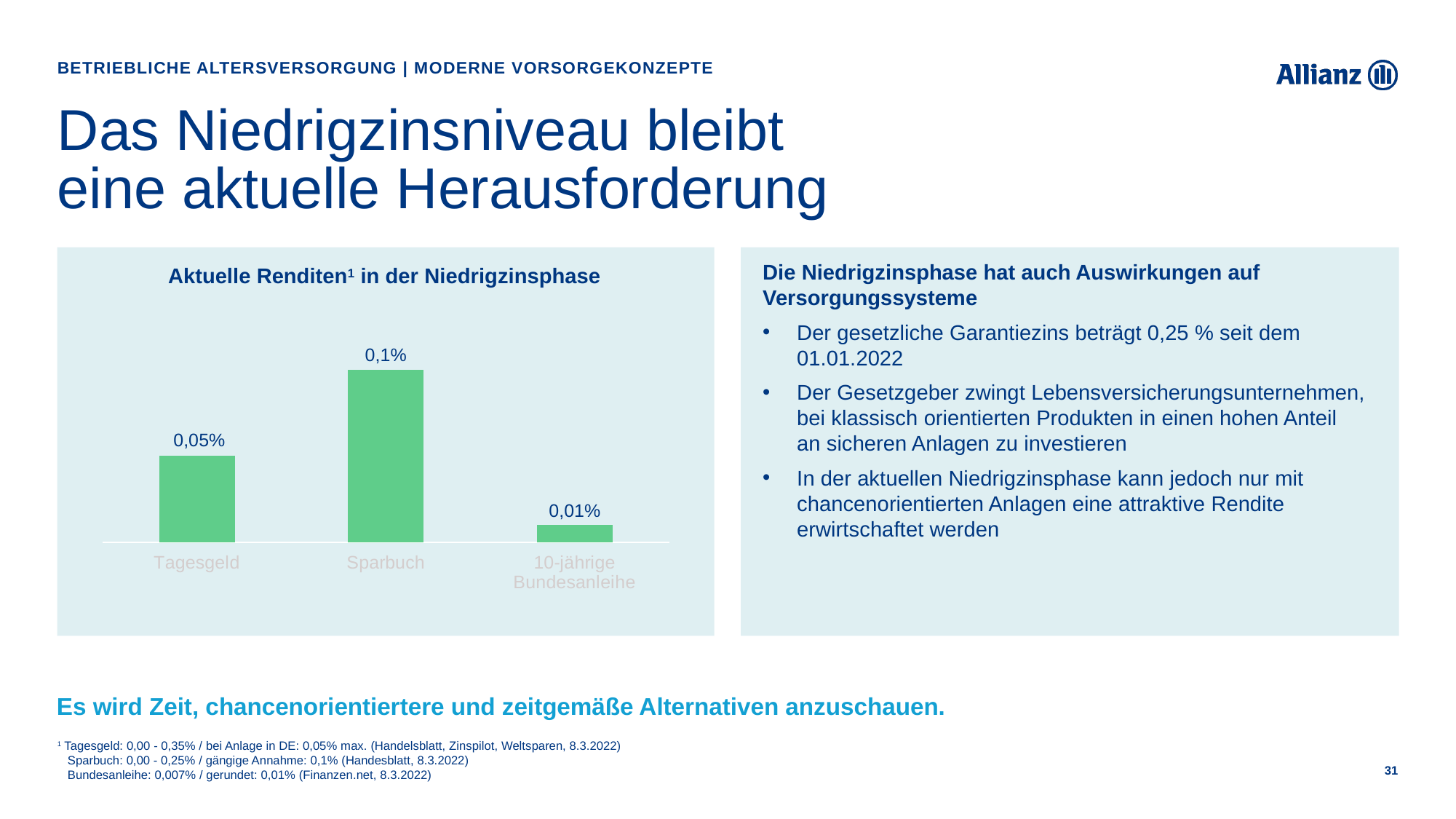
What is the value shown for 10-jährige Bundesanleihe? 0,01% Which category has the highest value? Sparbuch What is the difference between the values for Sparbuch and Tagesgeld? 0,05% What is the difference between the values for Tagesgeld and 10-jährige Bundesanleihe? 0,04% What kind of chart is shown on the slide? Bar chart Which category has the lowest value? 10-jährige Bundesanleihe What is the title of the chart? Aktuelle Renditen in der Niedrigzinsphase How many categories are shown in the chart? 3 What colour are the bars in the chart? Green What is the value shown for Sparbuch? 0,1% Which is larger, the value for Tagesgeld or the value for 10-jährige Bundesanleihe? Tagesgeld What is the value shown for Tagesgeld? 0,05%